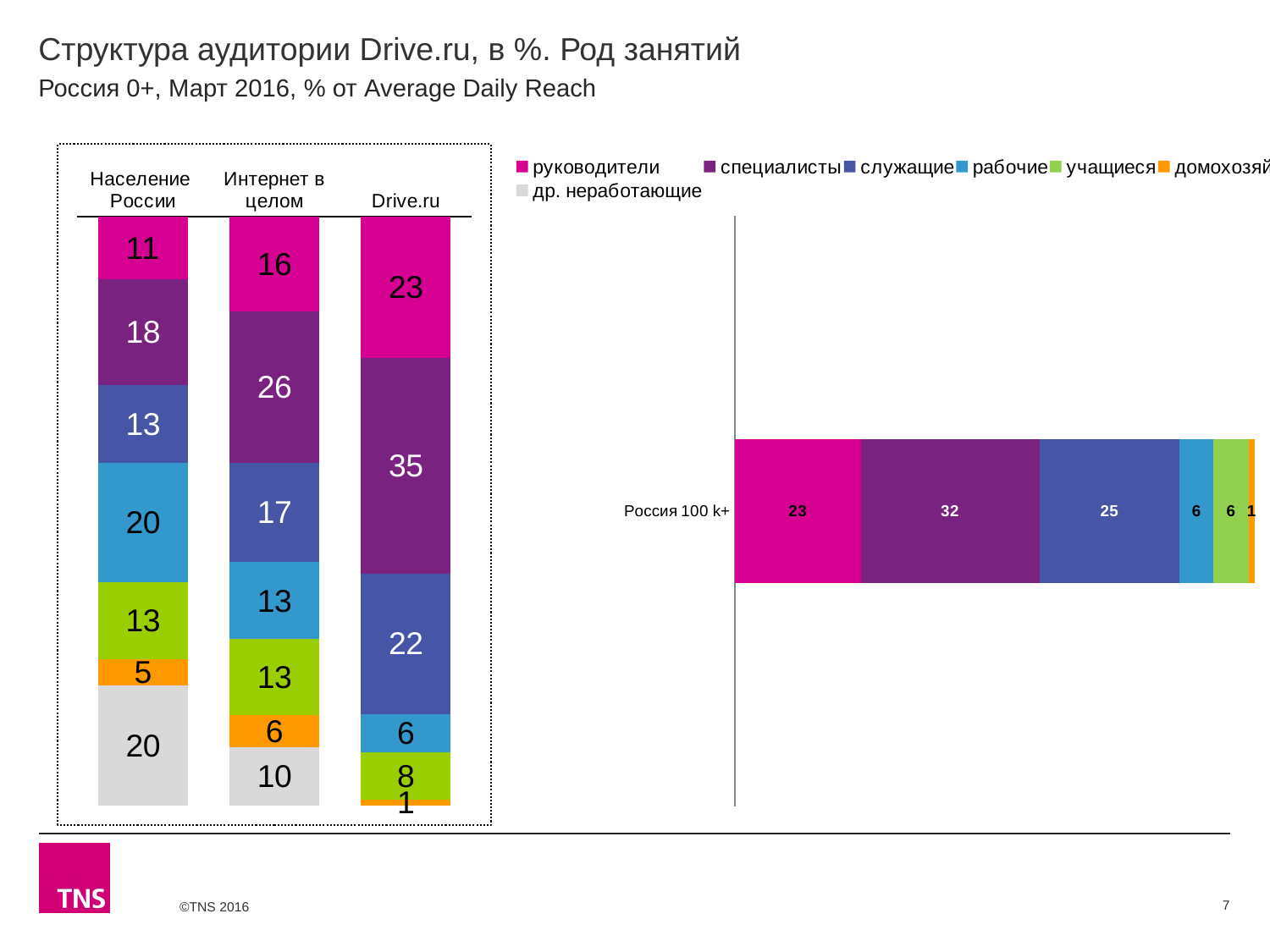
In the left chart, what is the value for рабочие in the Интернет в целом bar? 13 In the left chart, what is the value for руководители in the Население России bar? 11 In the left chart, which of the three bars has the largest руководители segment? Drive.ru How many series does the legend list? 7 What type of chart is the right chart? Stacked bar chart In the right chart, what is the total of the Россия 100 k+ bar? 93 In the right chart, what is the value for служащие in the Россия 100 k+ bar? 25 How many bars does the left chart show? 3 In the left chart, what is the difference between the специалисты values for Drive.ru and Население России? 17 In the left chart, which of the three bars has the smallest специалисты segment? Население России In the left chart, what is the value for специалисты in the Drive.ru bar? 35 In the left chart, is the рабочие value larger for Население России or for Drive.ru? Население России